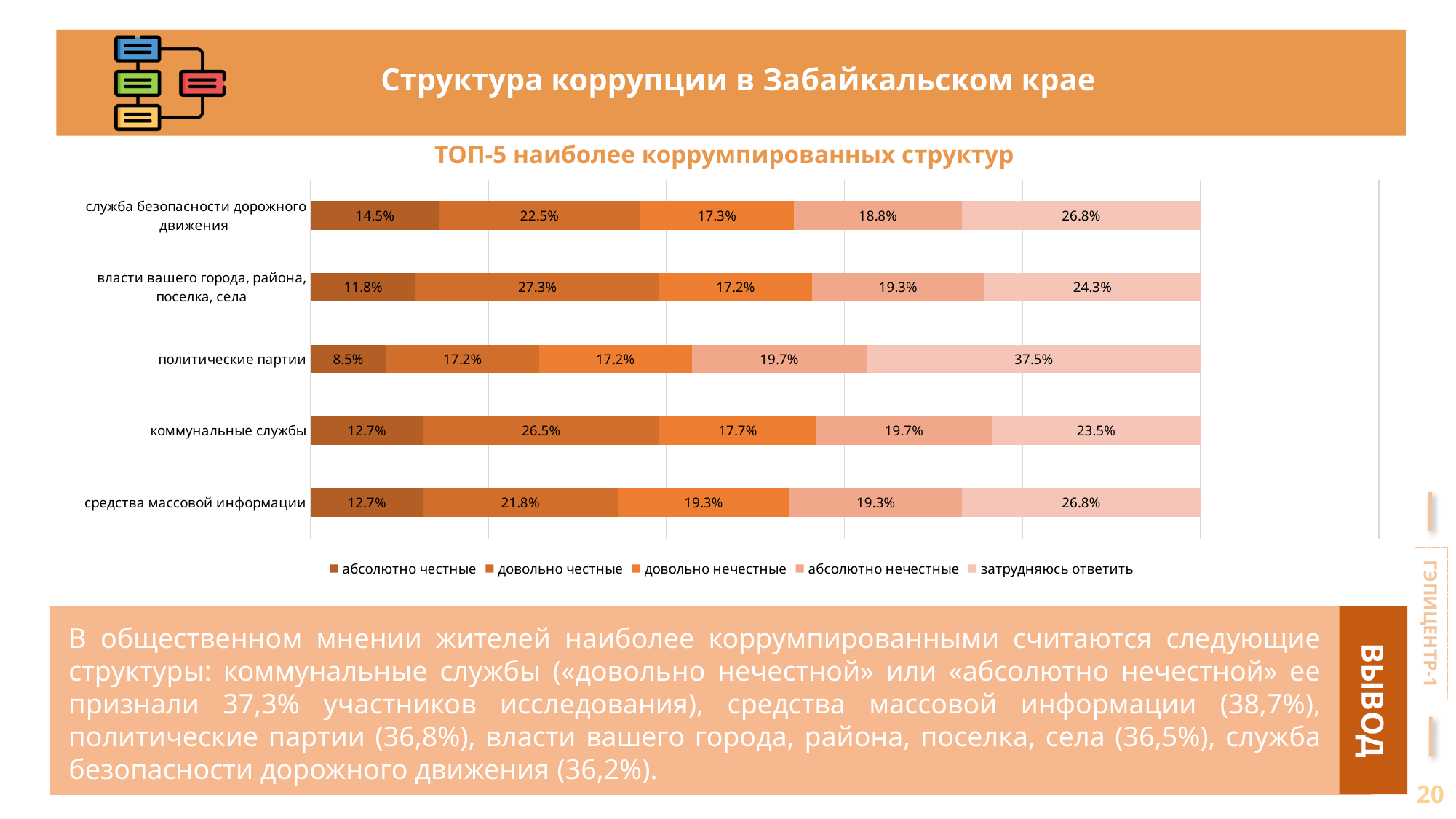
How many series does the legend list? 5 What is the «абсолютно нечестные» value for власти вашего города, района, поселка, села? 19.3% What is the difference between the «довольно честные» values for власти вашего города, района, поселка, села and средства массовой информации? 5.5 percentage points What percentage of respondents answered «затрудняюсь ответить» for политические партии? 37.5% How many categories (structures) are shown in the chart? 5 Which category has the highest «затрудняюсь ответить» share? политические партии Which category has the highest «довольно честные» share? власти вашего города, района, поселка, села What is the «абсолютно честные» value for служба безопасности дорожного движения? 14.5% What is the difference between the «затрудняюсь ответить» values for политические партии and коммунальные службы? 14 percentage points What type of chart is shown on the slide? Stacked bar chart Which has a larger «довольно честные» share: коммунальные службы or служба безопасности дорожного движения? коммунальные службы Which category has the lowest «абсолютно честные» share? политические партии